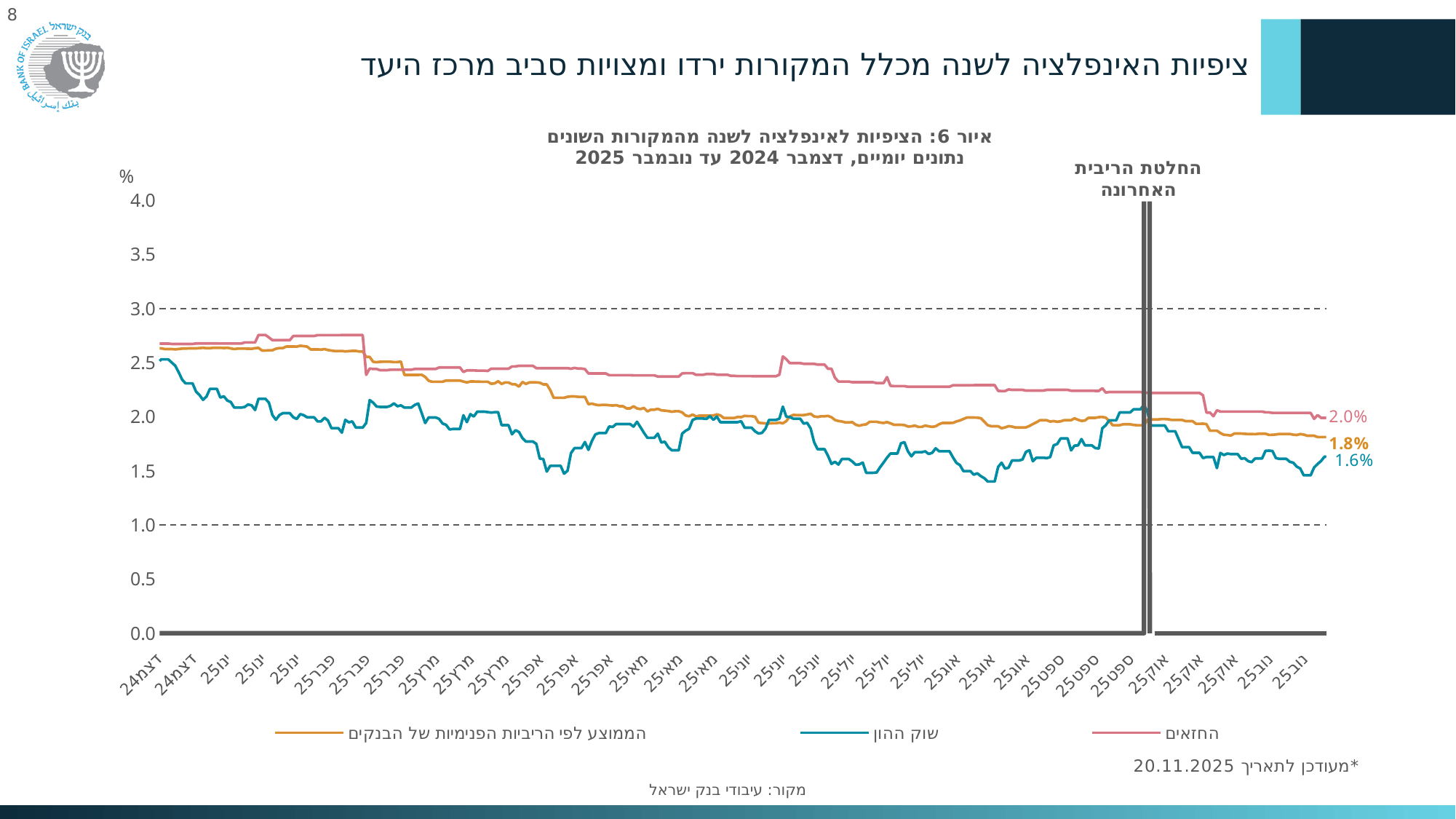
Which series has the highest value at the end of the period? החזאים Which series has the lowest value at the end of the period? שוק ההון What is the latest value labeled for the שוק ההון (capital market) series? 1.6% Do the values of the החזאים series generally rise or fall from December 2024 to November 2025? fall How many series does the legend list? 3 What does the label above the vertical line near October 2025 say? החלטת הריבית האחרונה What is the latest value labeled for the הממוצע לפי הריביות הפנימיות של הבנקים (banks' internal rates average) series? 1.8% At the end of the period, which is larger: the value for החזאים or the value for הממוצע לפי הריביות הפנימיות של הבנקים? החזאים What is the latest value labeled for the החזאים (forecasters) series? 2.0% What is the difference between the latest labeled values of החזאים and שוק ההון? 0.4% Is the value of the שוק ההון series at the start of the period (December 2024) greater or less than 2.0? greater What type of chart is shown on the slide? line chart